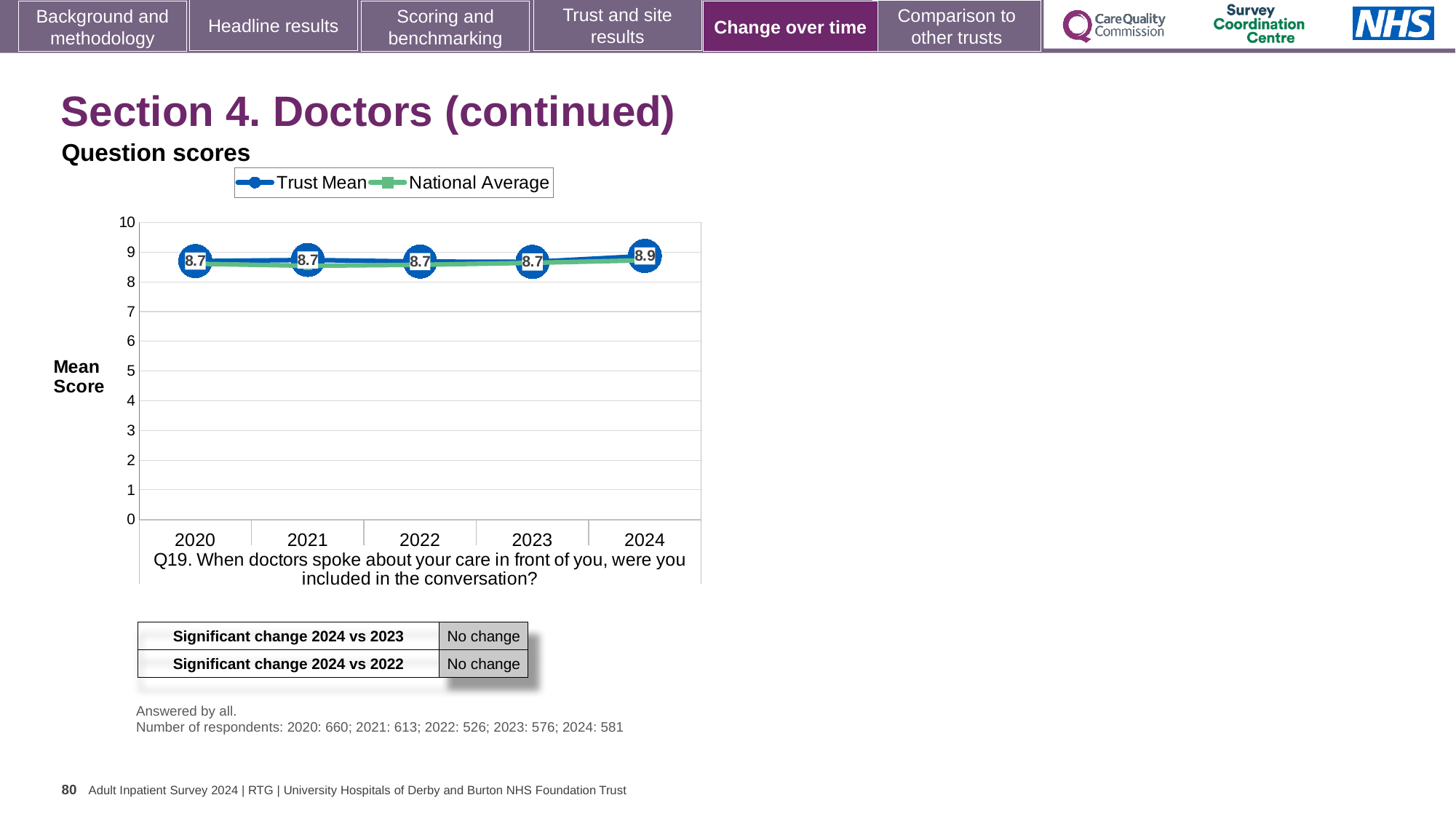
What is the Trust Mean score for 2024? 8.9 How many series does the legend list? 2 How many years are plotted on the x axis? 5 Is the Trust Mean value for 2023 greater or less than 9? less Is the National Average value for 2024 greater or less than 8? greater What is the Trust Mean score for 2020? 8.7 In which year is the Trust Mean score highest? 2024 What is the difference between the Trust Mean score in 2024 and in 2023? 0.2 Which is larger, the Trust Mean score for 2024 or for 2021? 2024 What is the label on the y axis of the chart? Mean Score What kind of chart is shown on the slide? Line chart What is the Trust Mean score for 2022? 8.7